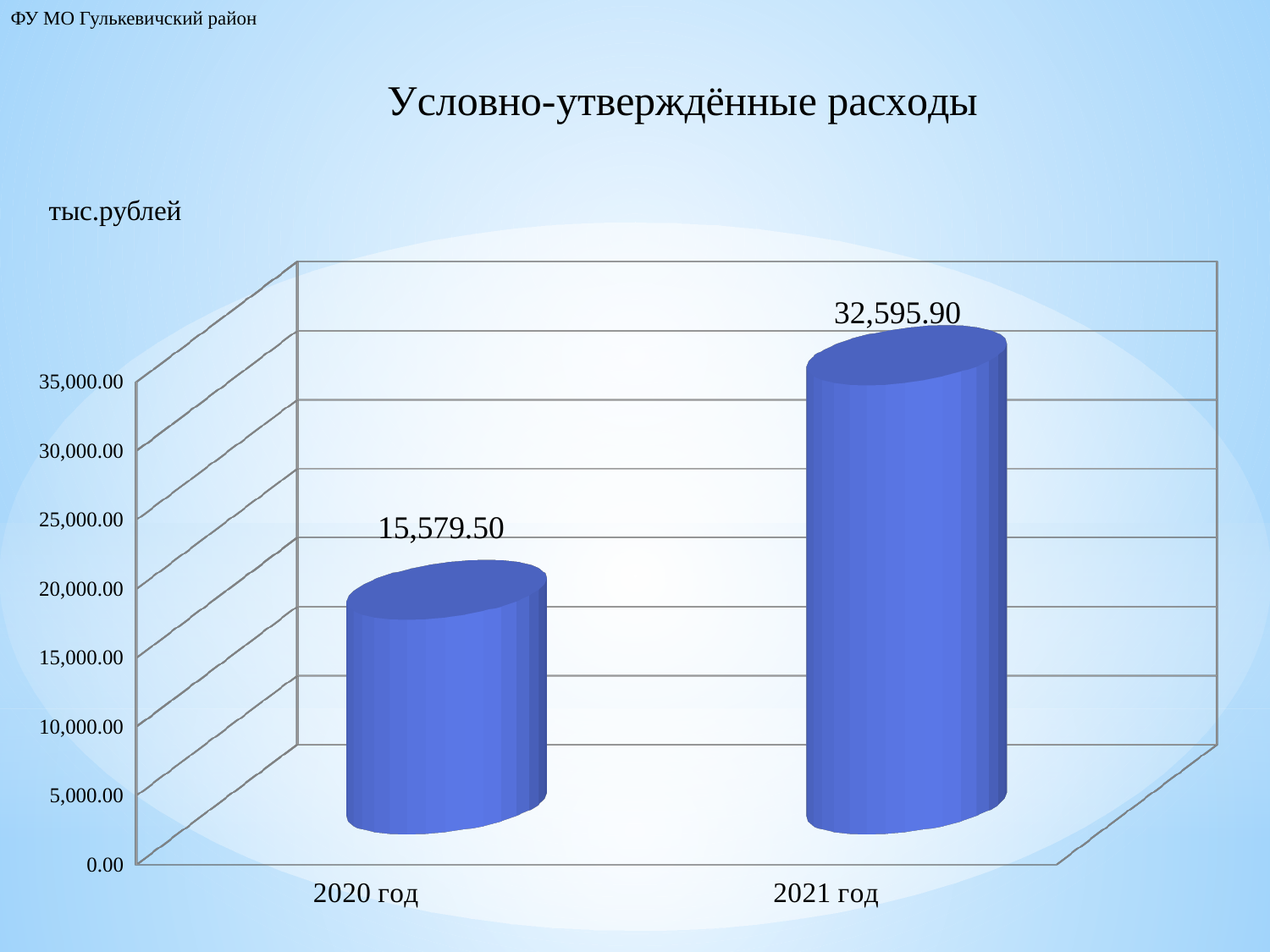
What is the title of the chart? Условно-утверждённые расходы What is the difference between the values for 2021 год and 2020 год? 17,016.40 What is the value for 2021 год? 32,595.90 What kind of chart is shown on the slide? bar chart Which is larger, the value for 2020 год or the value for 2021 год? 2021 год Is the value for 2020 год greater or less than 20,000.00? less What is the value for 2020 год? 15,579.50 How many categories are shown on the x axis? 2 Which year has the lowest value? 2020 год Do the values rise or fall from 2020 год to 2021 год? rise Which year has the highest value? 2021 год Is the value for 2021 год greater or less than 30,000.00? greater